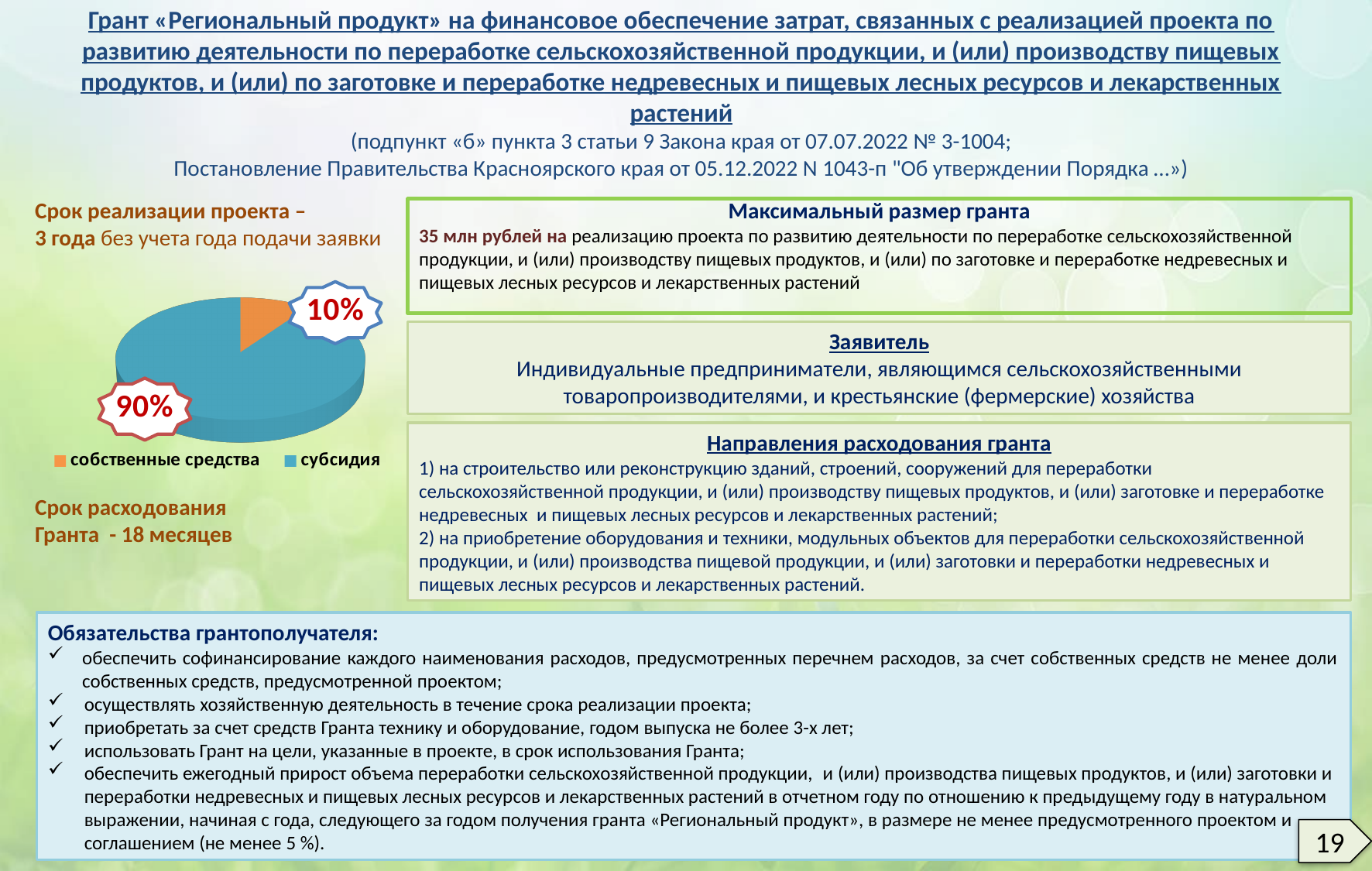
Which slice of the pie chart is the largest? субсидия Which is larger in the pie chart: "собственные средства" or "субсидия"? субсидия What kind of chart is shown on the slide? pie chart What colour is the "собственные средства" slice in the pie chart? orange How many entries does the pie chart legend list? 2 Which slice of the pie chart is the smallest? собственные средства What is the difference in percentage points between the "субсидия" slice and the "собственные средства" slice? 80% What share of the pie chart is labelled "собственные средства"? 10% What share of the pie chart is labelled "субсидия"? 90% How many slices does the pie chart have? 2 What colour is the "субсидия" slice in the pie chart? blue